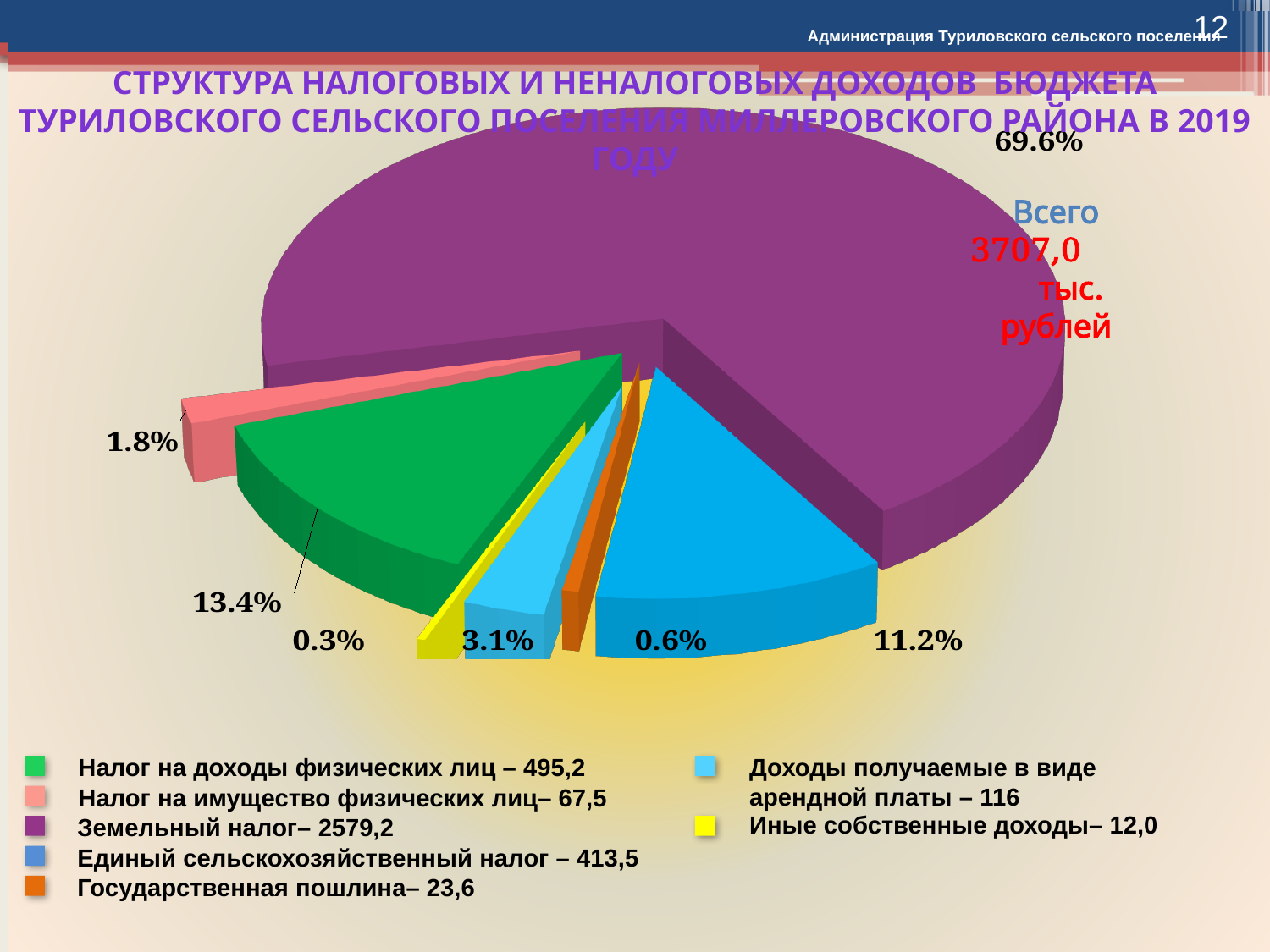
What is the difference in percentage points between the share for Земельный налог and the share for Налог на доходы физических лиц? 56.2% How many slices does the pie chart have? 7 Which category has the largest share of the pie? Земельный налог What share of the pie is labelled for Налог на доходы физических лиц? 13.4% What share of the pie is labelled for Единый сельскохозяйственный налог? 11.2% What kind of chart is shown on the slide? pie chart What total amount (Всего) is shown next to the pie chart? 3707,0 тыс. рублей Which is larger: the share for Налог на доходы физических лиц or the share for Единый сельскохозяйственный налог? Налог на доходы физических лиц Which category has the smallest share of the pie? Иные собственные доходы What value does the legend give for Земельный налог? 2579,2 What share of the pie is labelled for Государственная пошлина? 0.6%